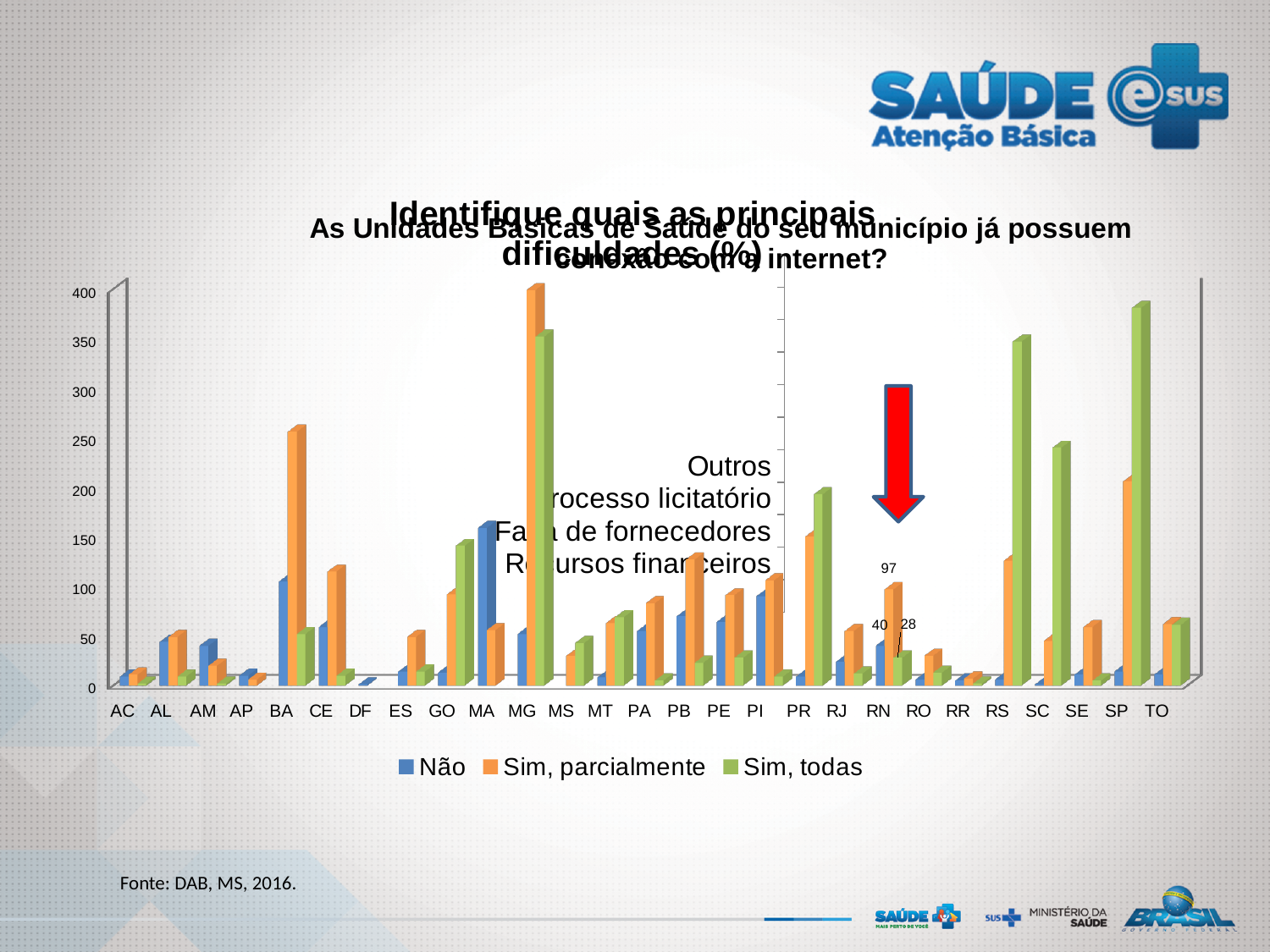
What is the value of the 'Sim, parcialmente' bar for RN? 97 Is the 'Sim, todas' value for SP greater or less than 300? greater For RN, which series has the highest value? Sim, parcialmente Is the 'Sim, parcialmente' value for MG greater or less than 350? greater What kind of chart is shown on the slide? Bar chart For RN, what is the difference between the 'Sim, parcialmente' value and the 'Não' value? 57 What are the three legend entries of the chart? Não; Sim, parcialmente; Sim, todas What is the value of the 'Sim, todas' bar for RN? 28 Which is larger: the 'Sim, todas' value for SP or the 'Sim, todas' value for SC? SP How many series does the legend list? 3 What is the value of the 'Não' bar for RN? 40 How many categories (states) are shown on the x axis? 27